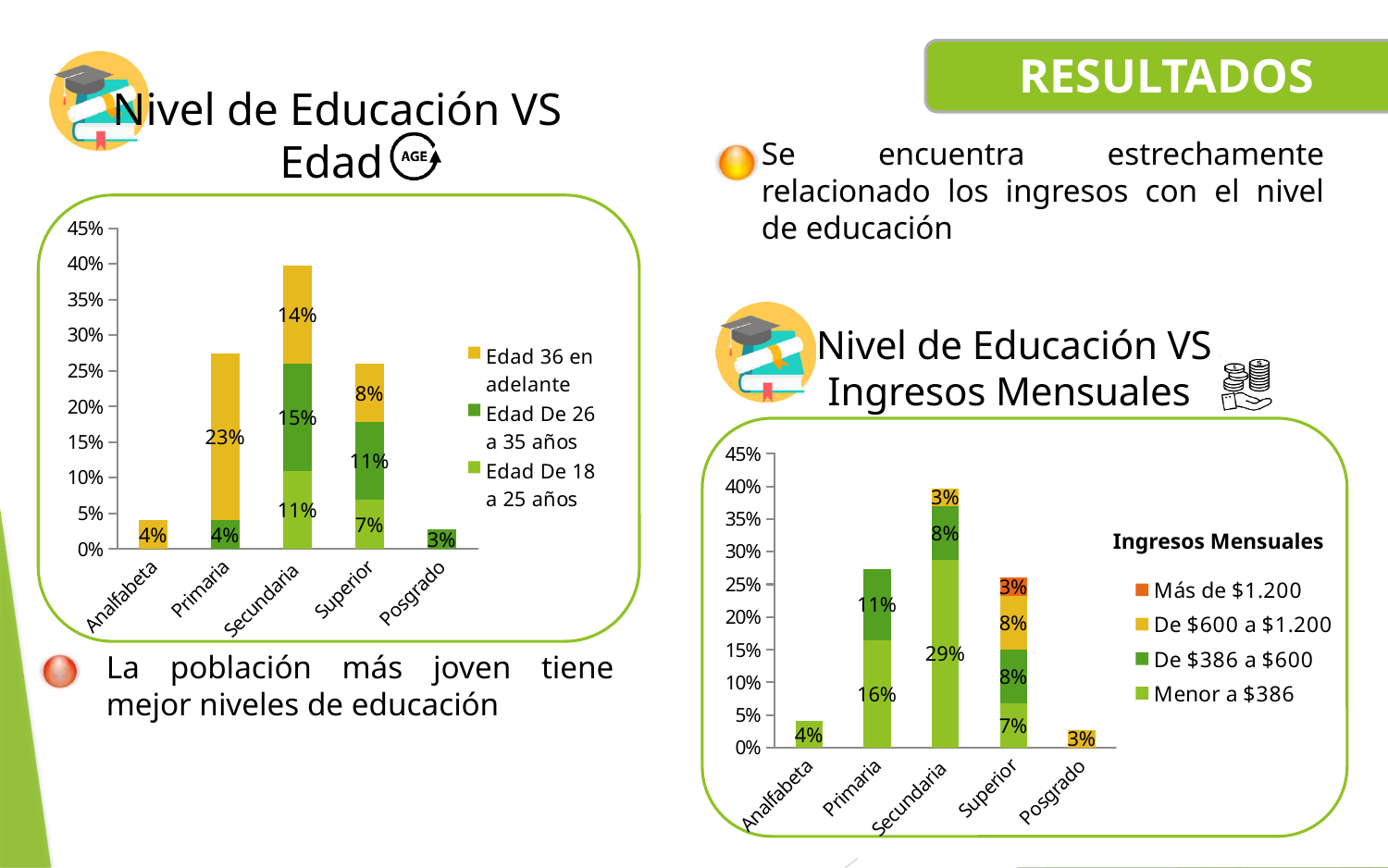
In the 'Nivel de Educación VS Edad' chart, what is the value for 'Edad De 26 a 35 años' in the Secundaria category? 15% In the 'Nivel de Educación VS Ingresos Mensuales' chart, which is larger: the 'Menor a $386' value for Primaria or for Superior? Primaria In the 'Nivel de Educación VS Edad' chart, how many series does the legend list? 3 In the 'Nivel de Educación VS Edad' chart, which category has the tallest stacked bar? Secundaria In the 'Nivel de Educación VS Ingresos Mensuales' chart, what is the value for 'De $386 a $600' in the Primaria category? 11% In the 'Nivel de Educación VS Edad' chart, what is the difference between the 'Edad 36 en adelante' values for Primaria and Secundaria? 9% In the 'Nivel de Educación VS Ingresos Mensuales' chart, what is the total of the stacked bar for Superior? 26% In the 'Nivel de Educación VS Edad' chart, what is the value for 'Edad 36 en adelante' in the Primaria category? 23% In the 'Nivel de Educación VS Ingresos Mensuales' chart, how many series does the legend list? 4 In the 'Nivel de Educación VS Ingresos Mensuales' chart, what is the value for 'Menor a $386' in the Secundaria category? 29% What kind of chart is 'Nivel de Educación VS Ingresos Mensuales'? Stacked bar chart In the 'Nivel de Educación VS Edad' chart, what is the total of the stacked bar for Secundaria? 40%